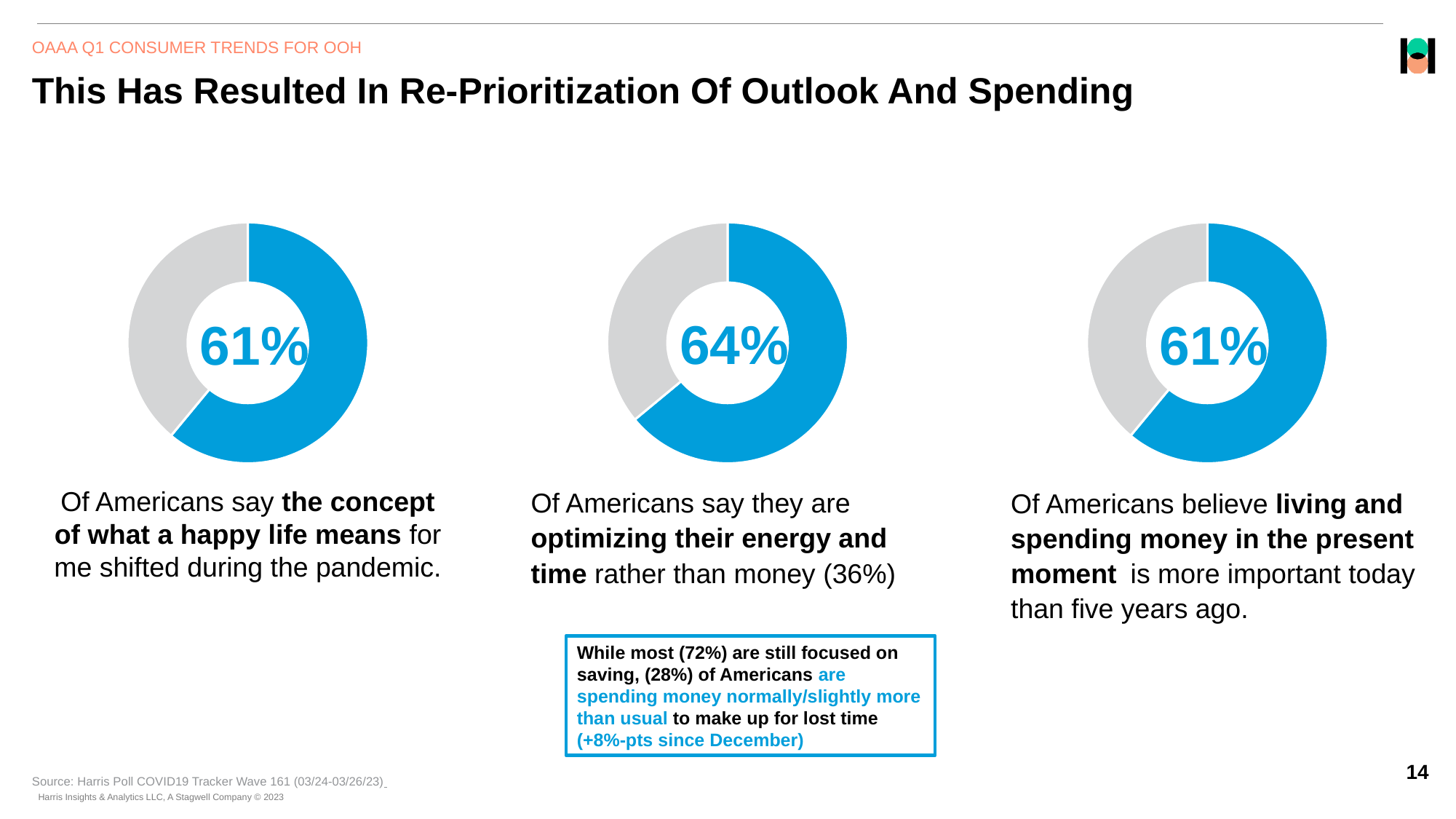
Do the left and right donut charts show the same percentage? Yes, both show 61% Is the value in the middle donut chart larger or smaller than the value in the right donut chart? Larger How many slices does each donut chart have? 2 In the right donut chart, what percentage of Americans believe living and spending money in the present moment is more important today than five years ago? 61% What is the difference in percentage points between the middle donut chart (64%) and the left donut chart (61%)? 3 percentage points What colour is the highlighted (value) slice in each donut chart? Blue How many donut charts are shown on the slide? 3 In the middle donut chart, what percentage of Americans say they are optimizing their energy and time rather than money? 64% According to the text next to the middle chart, what percentage of Americans say they are optimizing money rather than energy and time? 36% In the left donut chart, what percentage of Americans say the concept of what a happy life means for them shifted during the pandemic? 61% Which of the three donut charts shows the highest percentage? The middle chart (optimizing energy and time), 64% What kind of chart is used to show the three percentages on the slide? Donut (pie) chart